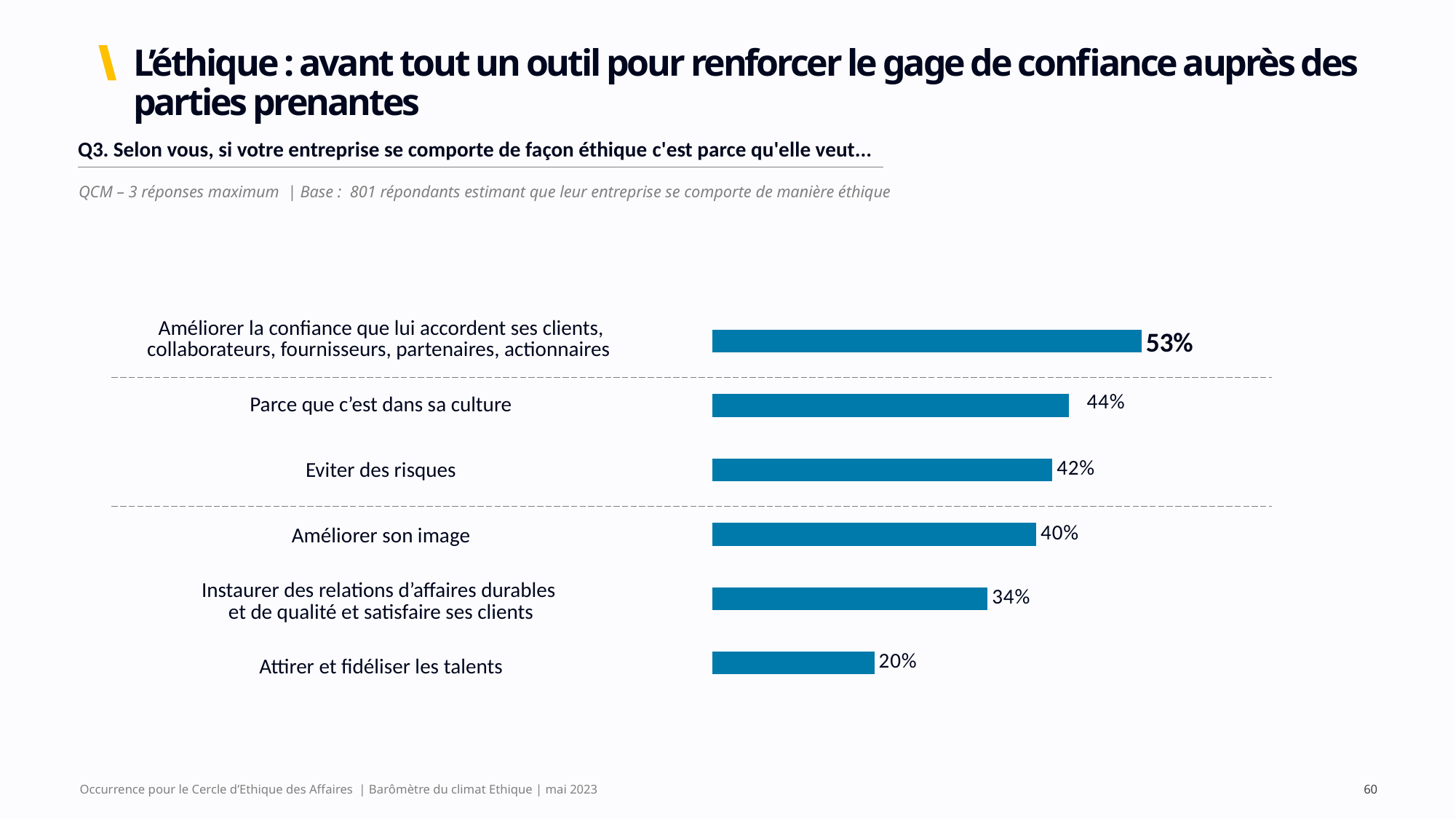
What is the value for "Parce que c'est dans sa culture"? 44% What is the base of respondents stated for this chart? 801 répondants What is the value for "Attirer et fidéliser les talents"? 20% Which category has the highest value? Améliorer la confiance que lui accordent ses clients, collaborateurs, fournisseurs, partenaires, actionnaires Which category has the lowest value? Attirer et fidéliser les talents What is the difference between the value for "Améliorer la confiance que lui accordent ses clients, collaborateurs, fournisseurs, partenaires, actionnaires" and the value for "Attirer et fidéliser les talents"? 33% What is the value for "Eviter des risques"? 42% What kind of chart is shown on the slide? Bar chart What is the value for "Améliorer son image"? 40% Which is larger: the value for "Parce que c'est dans sa culture" or the value for "Eviter des risques"? Parce que c'est dans sa culture What is the difference between the value for "Améliorer son image" and the value for "Instaurer des relations d'affaires durables et de qualité et satisfaire ses clients"? 6% How many categories are shown in the chart? 6